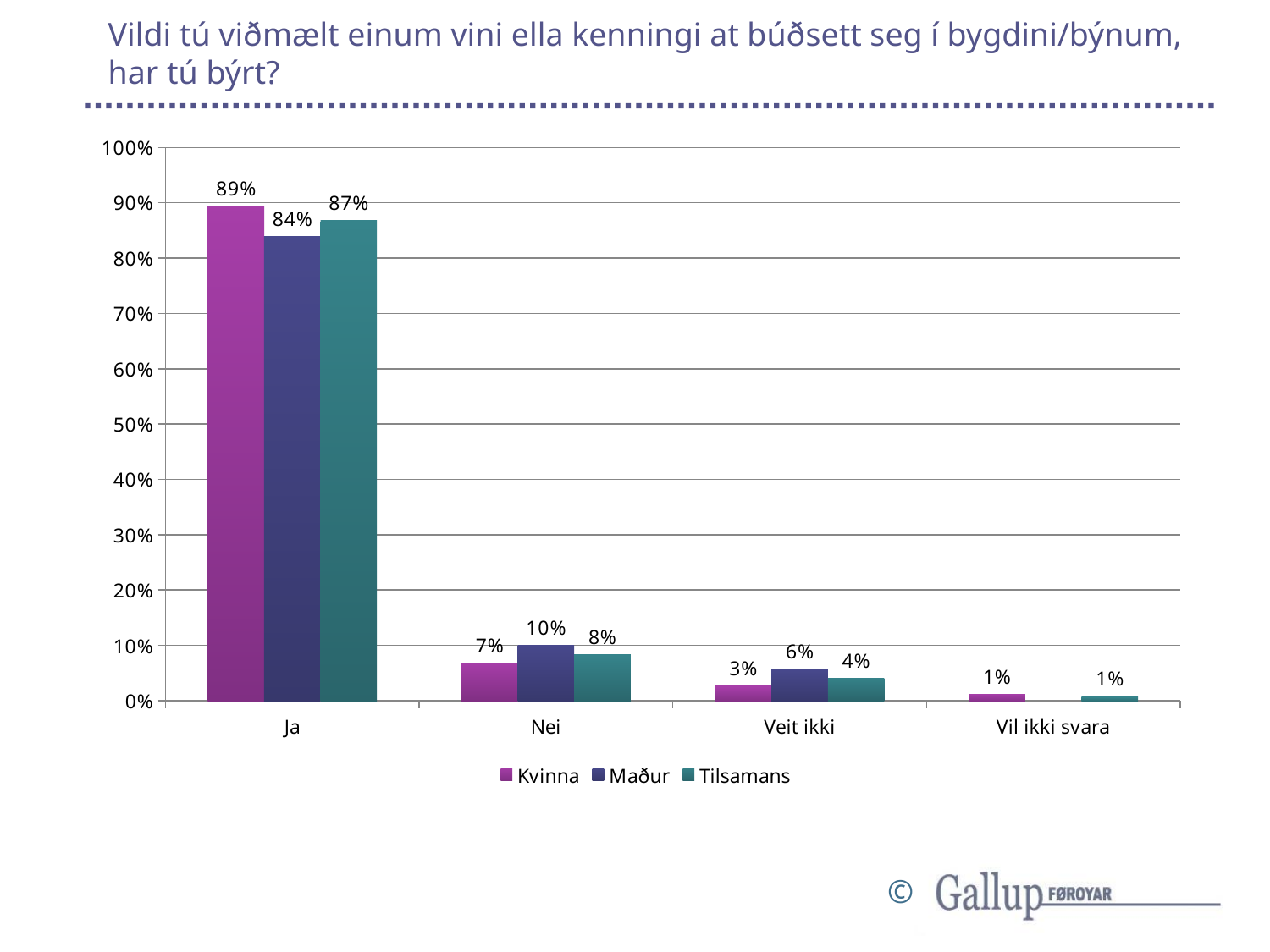
What is the value for Kvinna in the Vil ikki svara category? 1% What kind of chart is shown on the slide? bar chart How many series does the legend list? 3 How many categories are shown on the x axis? 4 Which category has the lowest value for Kvinna? Vil ikki svara What is the value for Maður in the Nei category? 10% In the Veit ikki category, which is larger: the Kvinna value or the Maður value? Maður Which category has the highest value for Tilsamans? Ja What is the value for Kvinna in the Ja category? 89% What is the value for Tilsamans in the Veit ikki category? 4% Is the value for Maður in the Ja category greater or less than 80%? greater What is the difference between the Kvinna and Maður values in the Ja category? 5%